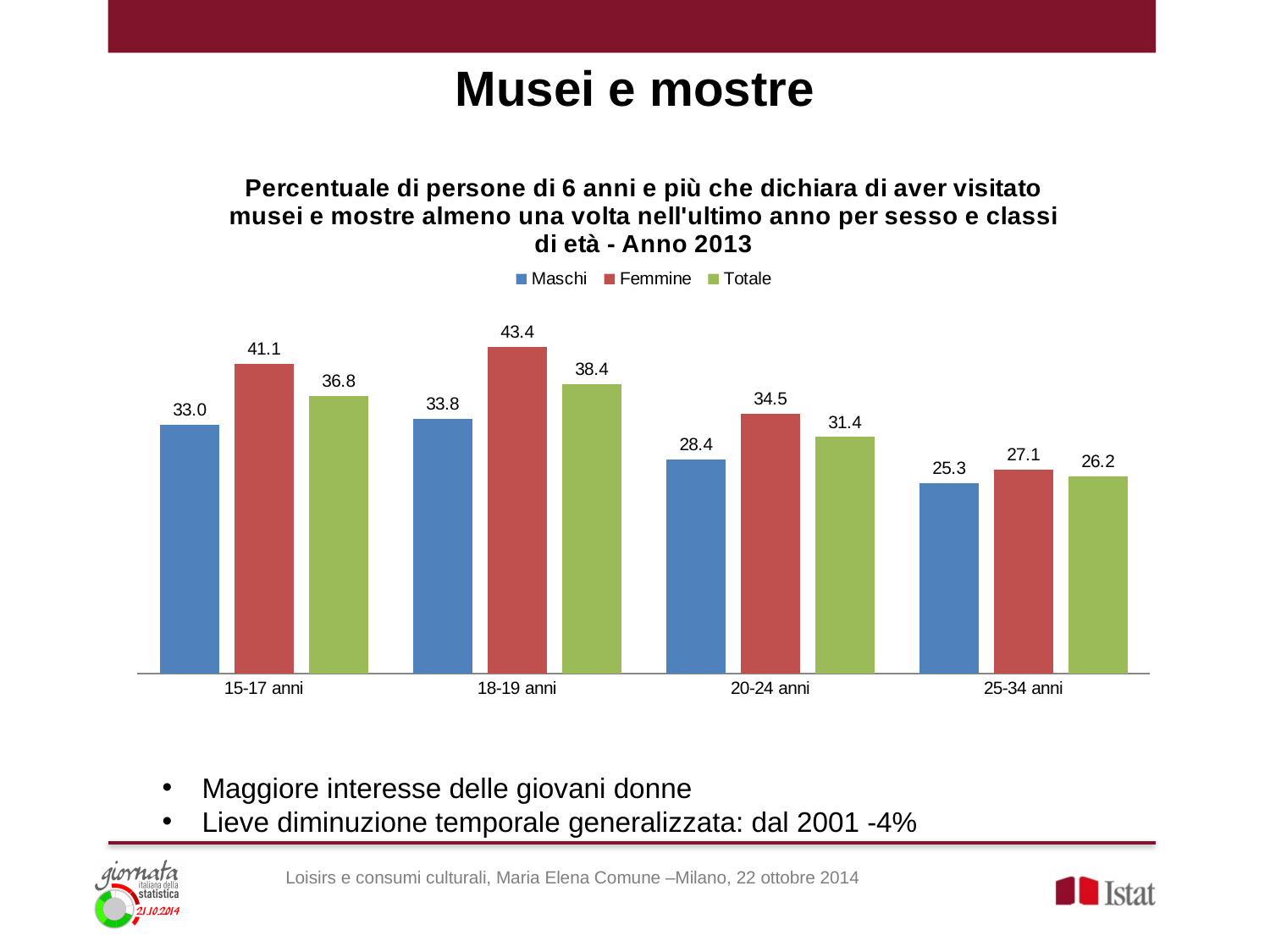
What is the value for Maschi in the 25-34 anni age group? 25.3 What is the value for Femmine in the 18-19 anni age group? 43.4 How many series does the legend list? 3 Do the Totale values rise or fall from the 18-19 anni group to the 25-34 anni group? Fall Which is larger: the Maschi value for 18-19 anni or the Maschi value for 20-24 anni? 18-19 anni What kind of chart is shown on the slide? Bar chart Which age group has the highest Femmine value? 18-19 anni Which colour represents the Femmine series in the chart? Red Which age group has the lowest Totale value? 25-34 anni How many age groups are shown on the x axis? 4 What is the Totale value for the 20-24 anni age group? 31.4 What is the difference between the Femmine and Maschi values for the 15-17 anni age group? 8.1